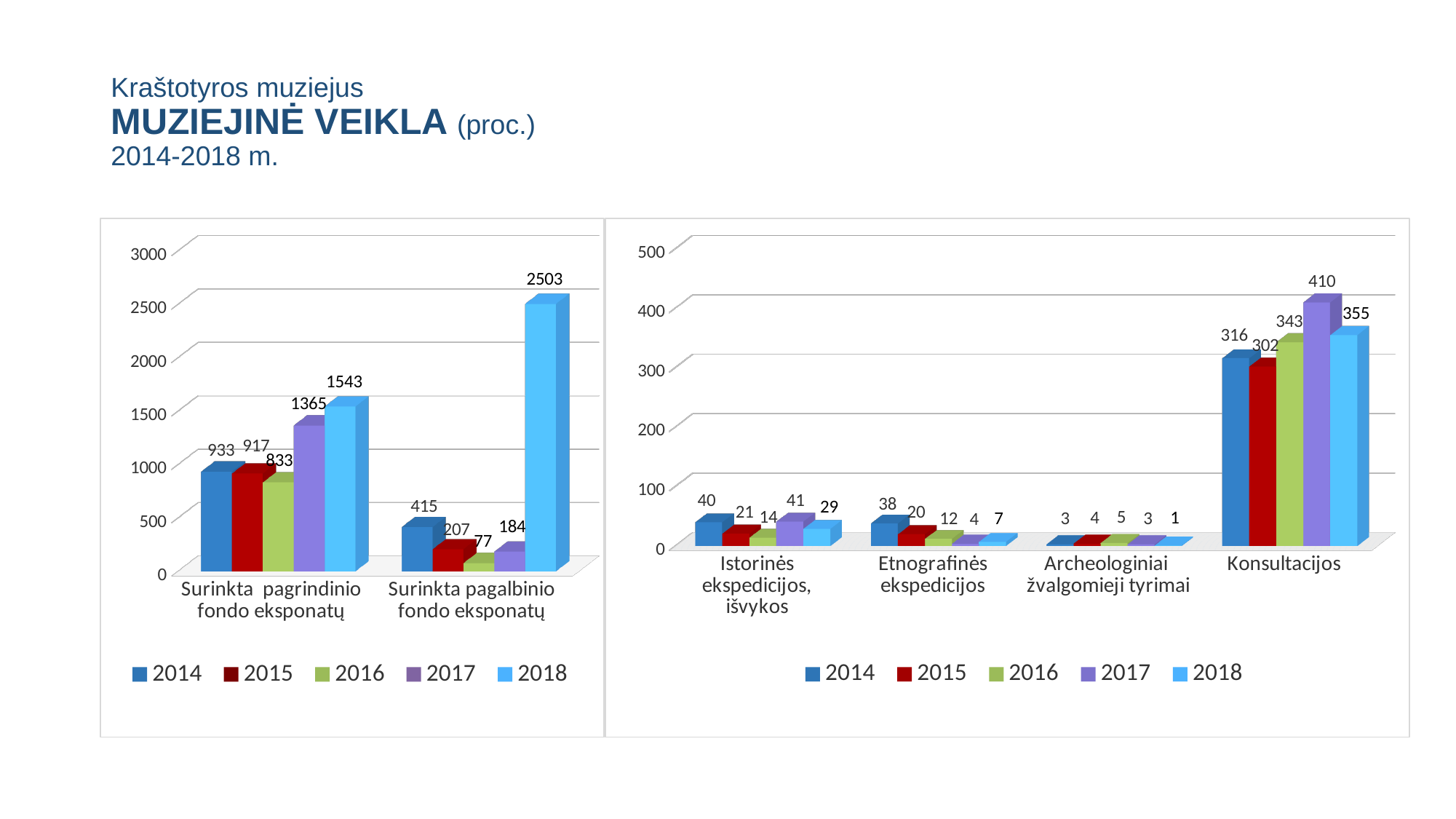
In the left chart, what is the 2016 value for Surinkta pagrindinio fondo eksponatų? 833 In the right chart, what is the difference between the 2014 and 2018 values for Archeologiniai žvalgomieji tyrimai? 2 In the right chart, which is larger for Konsultacijos: the 2016 value or the 2018 value? 2018 In the left chart, how many series does the legend list? 5 In the right chart, what is the 2017 value for Konsultacijos? 410 In the left chart, what is the difference between the 2018 and 2017 values for Surinkta pagrindinio fondo eksponatų? 178 In the right chart, how many categories are shown on the x axis? 4 What kind of chart is the left chart? bar chart In the right chart, which year has the highest value for Istorinės ekspedicijos, išvykos? 2017 In the left chart, which year has the lowest value for Surinkta pagalbinio fondo eksponatų? 2016 In the right chart, what is the 2015 value for Etnografinės ekspedicijos? 20 In the left chart, what is the 2018 value for Surinkta pagalbinio fondo eksponatų? 2503